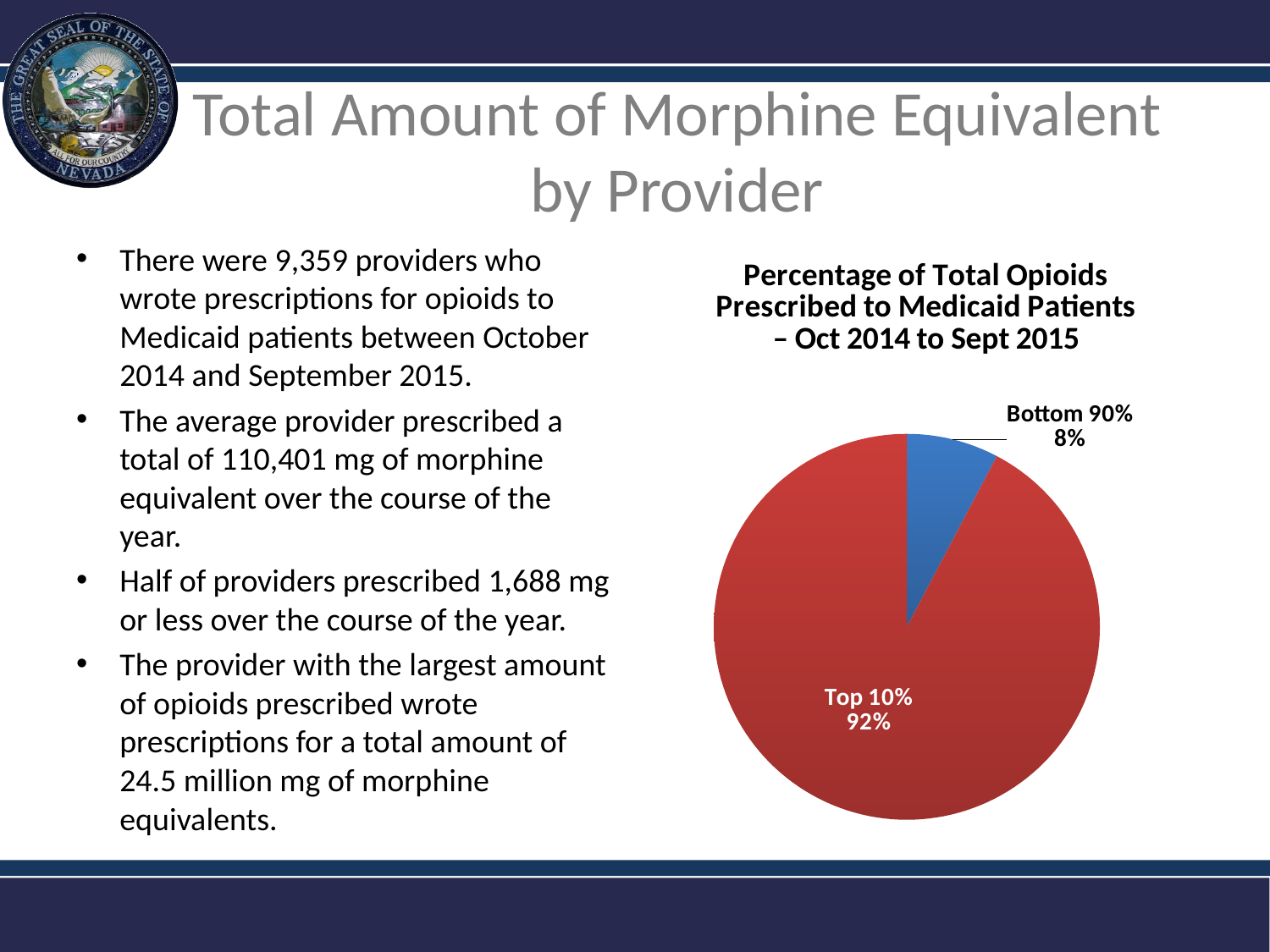
Which slice of the pie chart is the largest? Top 10% What percentage of total opioids prescribed to Medicaid patients is attributed to the Top 10% of providers? 92% What is the title of the pie chart? Percentage of Total Opioids Prescribed to Medicaid Patients – Oct 2014 to Sept 2015 Which is larger, the share for the Top 10% or the share for the Bottom 90%? Top 10% What percentage of total opioids prescribed to Medicaid patients is attributed to the Bottom 90% of providers? 8% What share of the pie does the Bottom 90% slice represent? 8% Which slice of the pie chart is the smallest? Bottom 90% What is the difference in percentage points between the Top 10% slice and the Bottom 90% slice? 84 What colour is the Top 10% slice of the pie chart? Red What kind of chart is shown on the slide? Pie chart How many slices does the pie chart have? 2